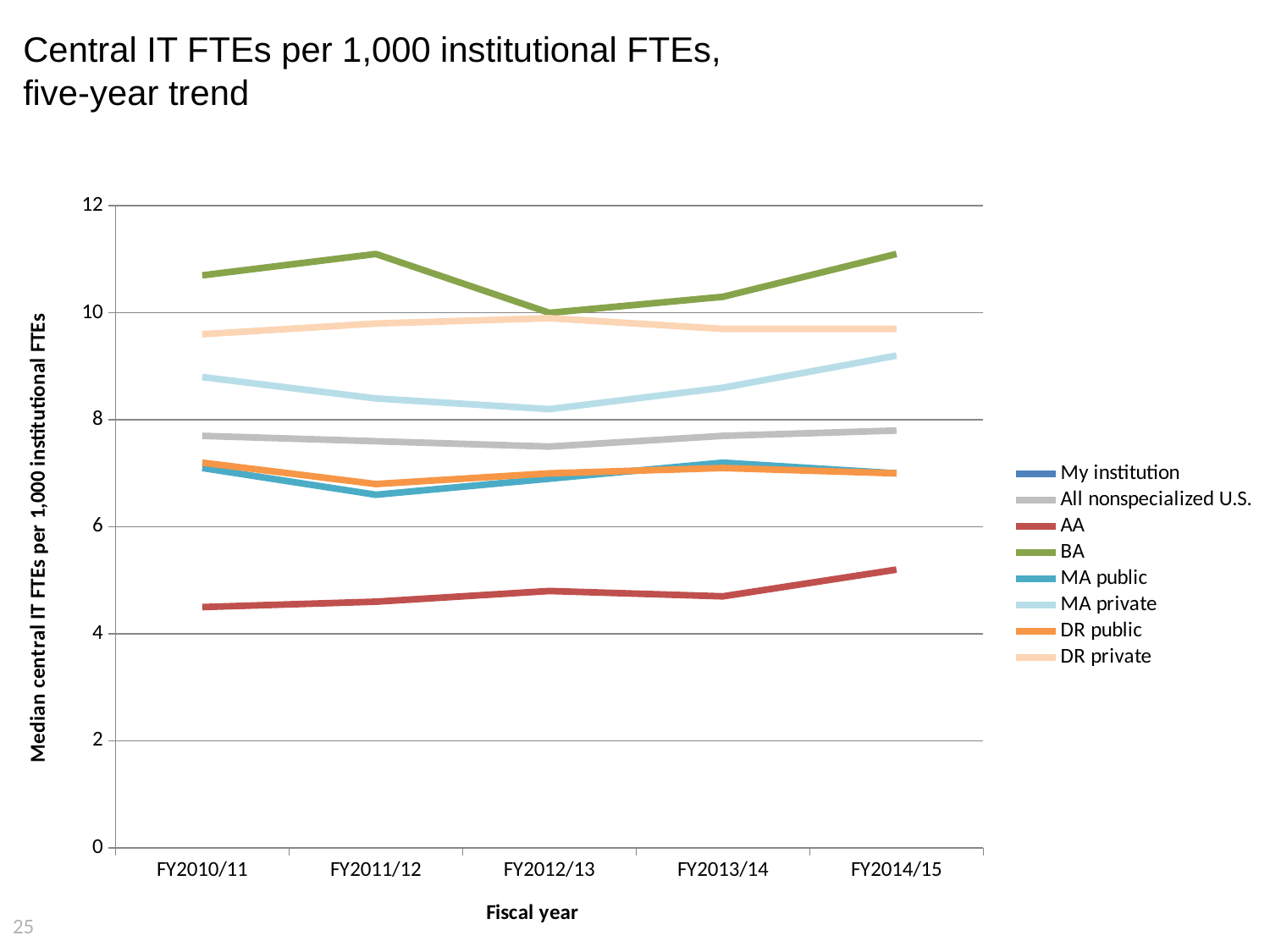
Does the AA line rise or fall from FY2010/11 to FY2014/15? rise What is the title of the y axis? Median central IT FTEs per 1,000 institutional FTEs Is the value for MA private in FY2014/15 greater or less than 8? greater Which series has the lowest value in FY2010/11? AA What kind of chart is shown on the slide? line chart How many fiscal years are shown on the x axis? 5 Which series has the highest value in FY2014/15? BA In FY2010/11, which is larger: BA or MA private? BA Is the value for BA in FY2011/12 greater or less than 10? greater Is the value for AA in FY2014/15 greater or less than 6? less How many series does the legend list? 8